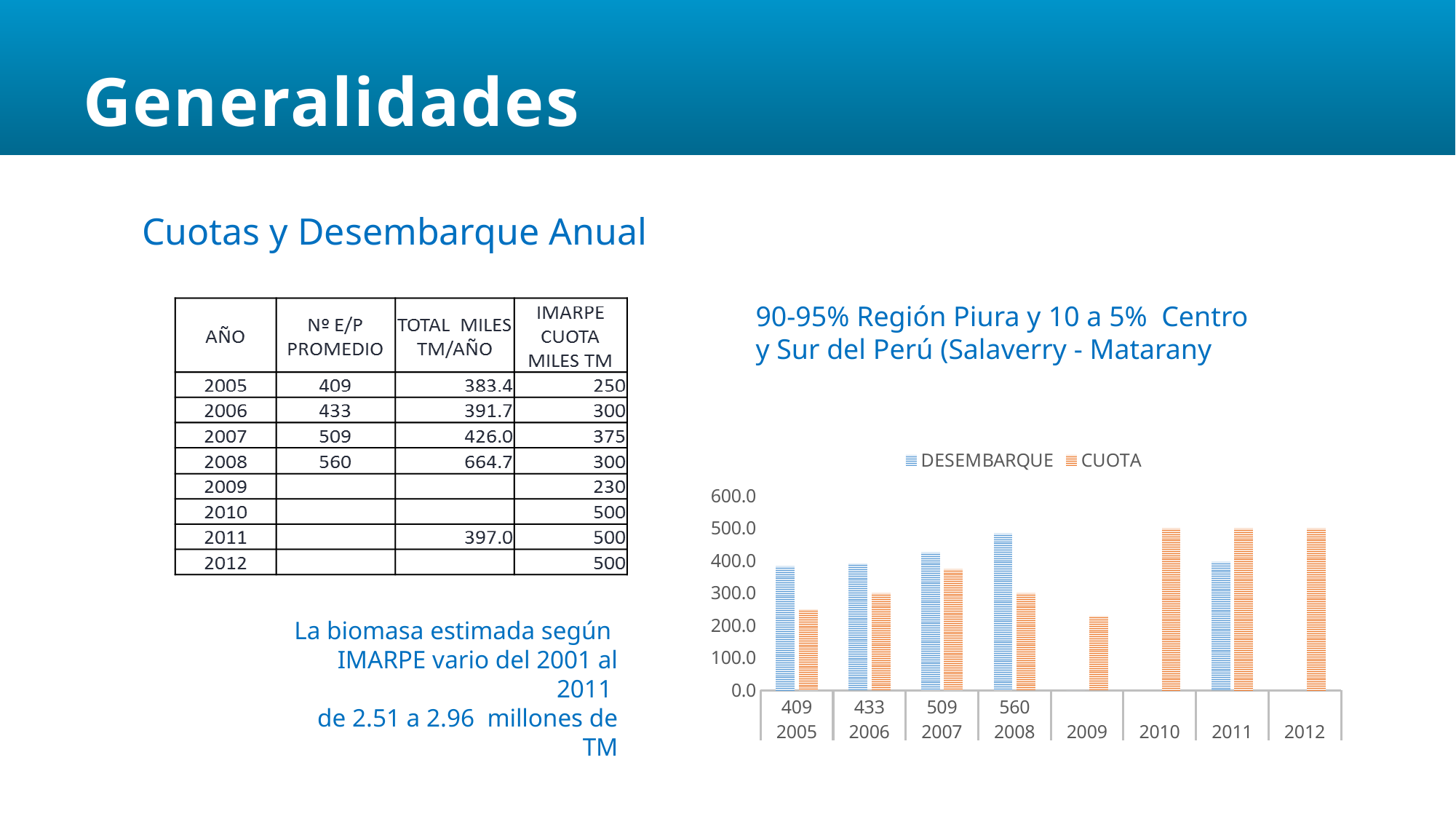
Is the DESEMBARQUE value for 2008 greater or less than 400.0? greater What is the CUOTA value for 2006 in the chart? 300.0 What is the CUOTA value for 2010 in the chart? 500.0 Which series in the chart is drawn in orange? CUOTA Which year has the highest DESEMBARQUE bar in the chart? 2008 What kind of chart is shown on the slide? Bar chart Is the CUOTA value for 2009 greater or less than 300.0? less Do the DESEMBARQUE bars rise or fall from 2005 to 2008? Rise How many series does the chart legend list? 2 How many years are shown along the x axis of the chart? 8 In 2005, which is larger in the chart, DESEMBARQUE or CUOTA? DESEMBARQUE In 2011, which is larger in the chart, DESEMBARQUE or CUOTA? CUOTA